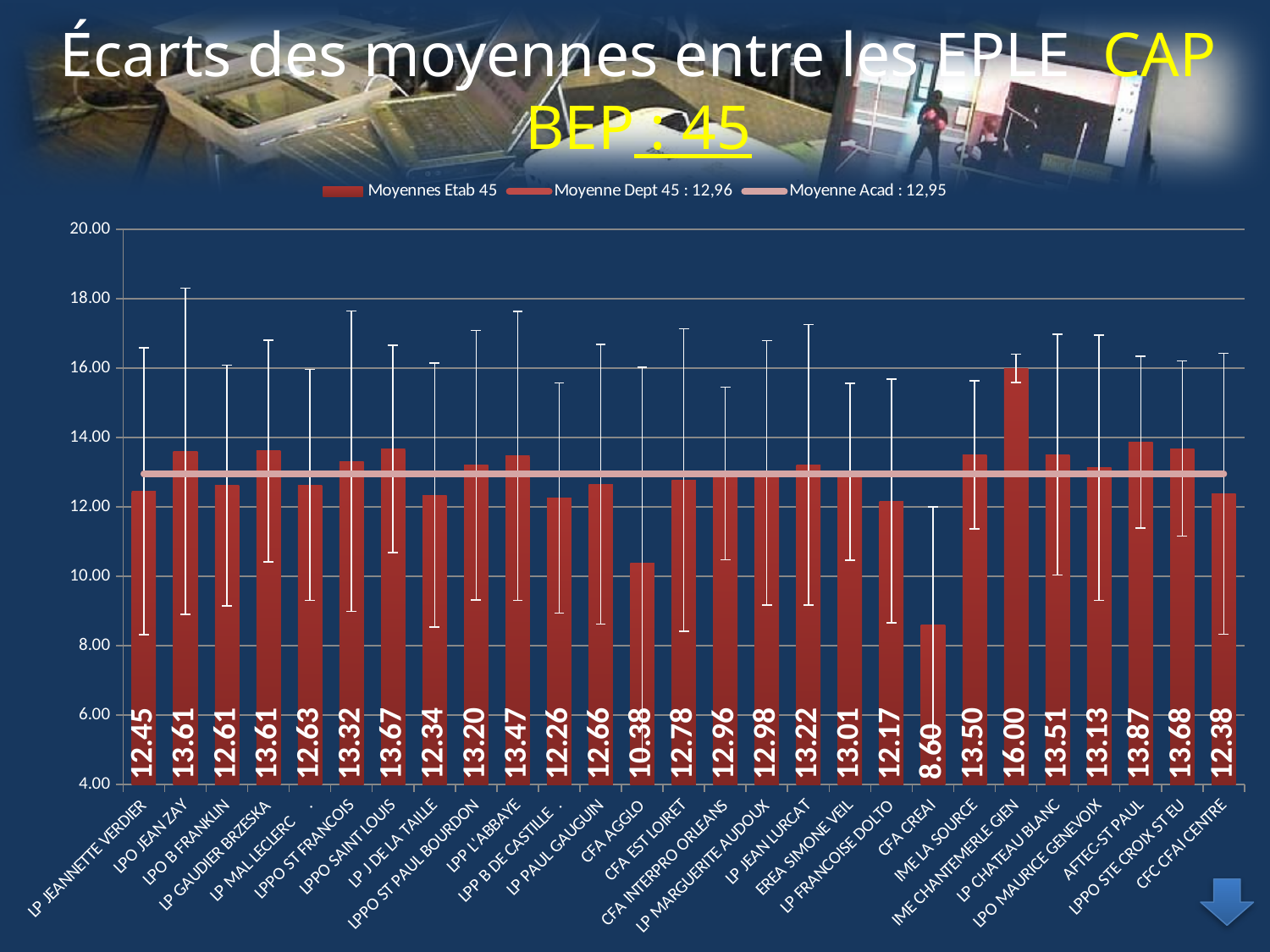
What kind of chart is shown? bar chart Is the value for CFA CREAI greater or less than 10.00? less How many establishments are shown on the x axis? 27 Which establishment has the lowest value? CFA CREAI Which establishment has the highest value? IME CHANTEMERLE GIEN What is the value for LP JEANNETTE VERDIER? 12.45 How many series does the legend list? 3 What is the value for IME CHANTEMERLE GIEN? 16.00 What is the difference between the values for IME CHANTEMERLE GIEN and CFA CREAI? 7.40 What is the value for CFA AGGLO? 10.38 According to the legend, what is the Moyenne Dept 45? 12,96 Which is larger, the value for AFTEC-ST PAUL or the value for LP FRANCOISE DOLTO? AFTEC-ST PAUL